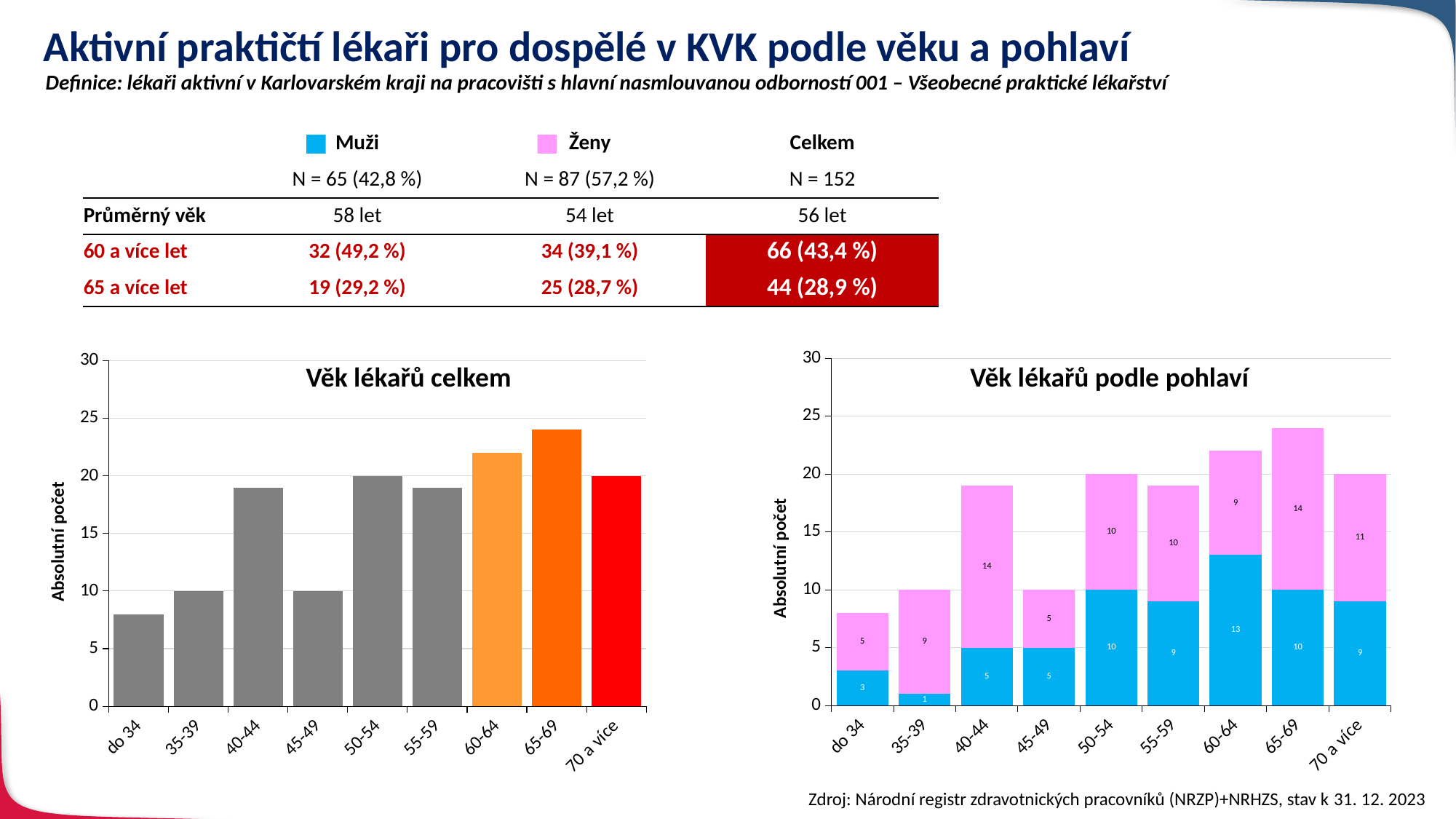
What kind of chart is "Věk lékařů podle pohlaví"? stacked bar chart In the chart titled "Věk lékařů podle pohlaví", what is the total of the stacked bar for the 70 a více age group? 20 In the chart titled "Věk lékařů podle pohlaví", which is larger in the 35-39 age group, Muži or Ženy? Ženy In the chart titled "Věk lékařů celkem", which age group has the lowest bar? do 34 In the chart titled "Věk lékařů podle pohlaví", what is the value for Muži in the 60-64 age group? 13 In the chart titled "Věk lékařů celkem", how many age groups are shown on the x axis? 9 In the chart titled "Věk lékařů podle pohlaví", what is the value for Ženy in the 65-69 age group? 14 In the chart titled "Věk lékařů celkem", is the value for the 40-44 age group greater or less than 15? greater In the chart titled "Věk lékařů celkem", which age group has the highest bar? 65-69 In the chart titled "Věk lékařů podle pohlaví", what is the difference between Ženy and Muži in the 40-44 age group? 9 In the chart titled "Věk lékařů podle pohlaví", which colour represents Ženy? pink In the chart titled "Věk lékařů celkem", what is the value for the 50-54 age group? 20